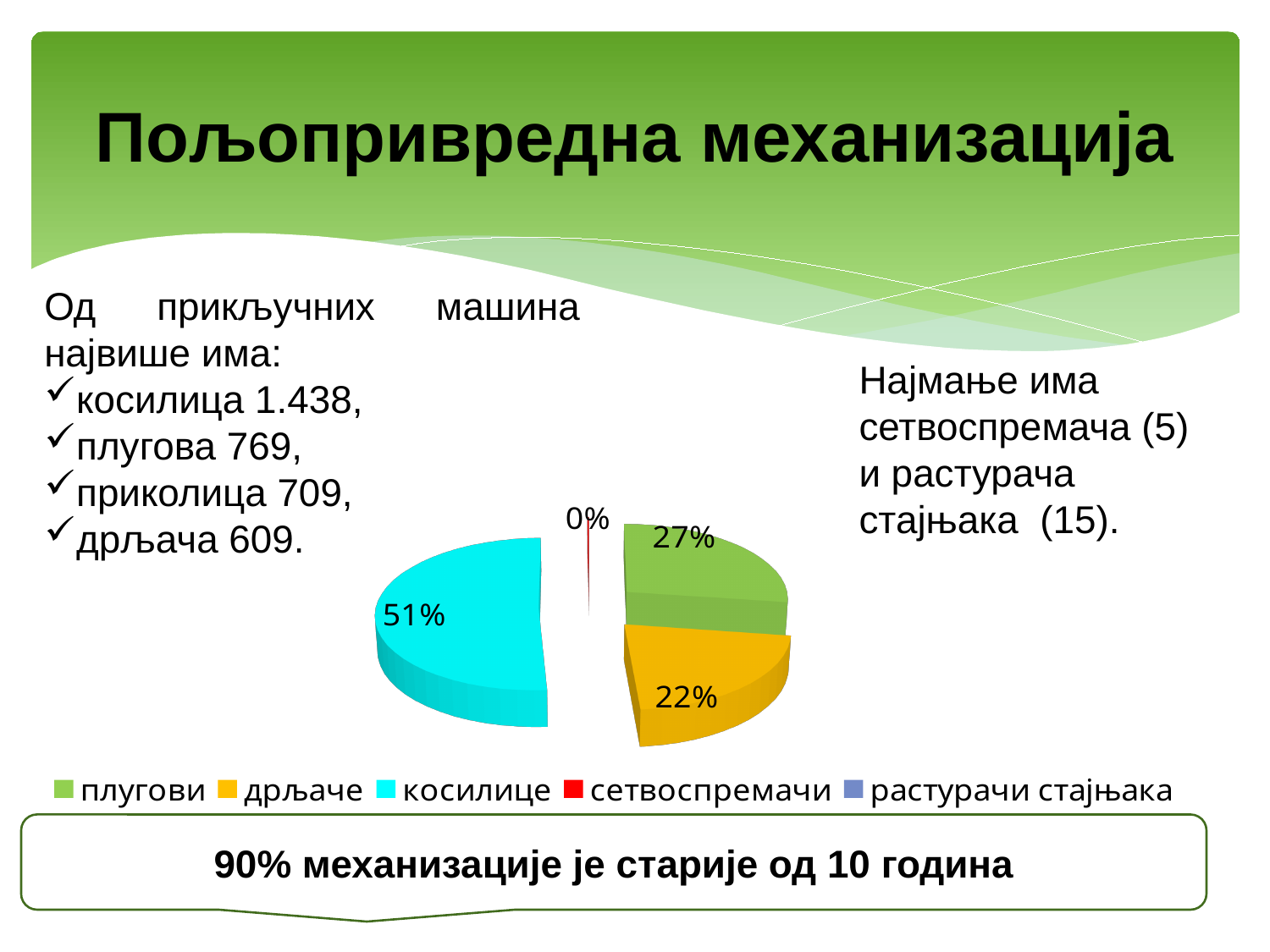
What percentage of the pie chart does the slice for косилице represent? 51% What value is shown for плугови in the pie chart? 27% What colour is the косилице slice in the pie chart? cyan Which category has the largest slice in the pie chart? косилице What is the difference in percentage points between the плугови slice and the дрљаче slice? 5 Which legend entry is shown in red? сетвоспремачи What percentage label is shown for the сетвоспремачи slice? 0% What type of chart is shown on the slide? pie chart How many categories does the legend of the pie chart list? 5 Which slice is larger, плугови or дрљаче? плугови What value is shown for дрљаче in the pie chart? 22% What is the difference in percentage points between the косилице slice and the плугови slice? 24